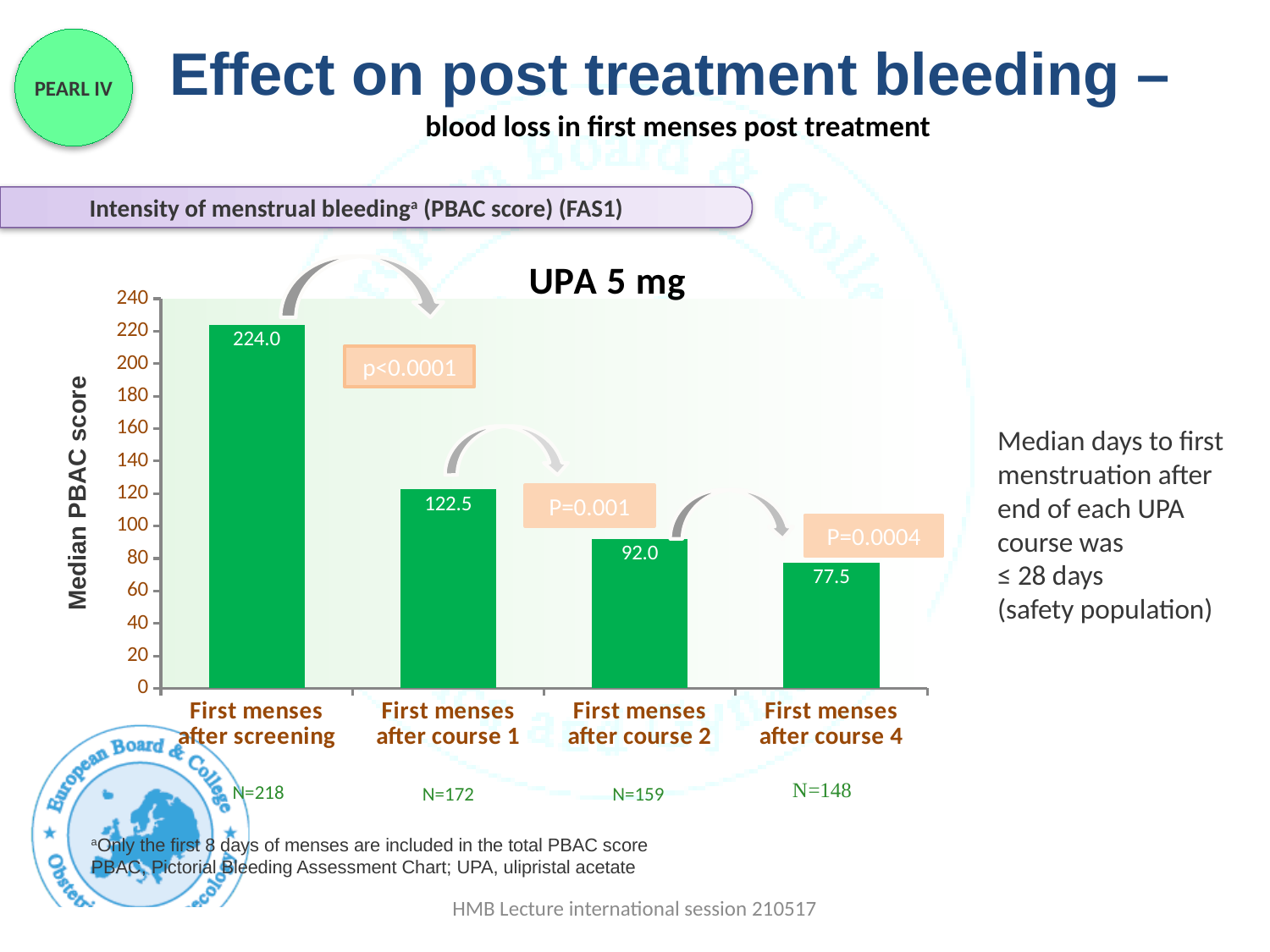
Which category has the highest median PBAC score? First menses after screening What is the median PBAC score for first menses after course 4? 77.5 What is the median PBAC score for first menses after screening? 224.0 Which is larger, the median PBAC score after course 1 or after course 2? After course 1 What is the median PBAC score for first menses after course 1? 122.5 Which category has the lowest median PBAC score? First menses after course 4 What is the difference in median PBAC score between first menses after course 2 and first menses after course 4? 14.5 Do the median PBAC scores rise or fall from left to right across the chart? Fall What is the difference in median PBAC score between first menses after screening and first menses after course 1? 101.5 What is the median PBAC score for first menses after course 2? 92.0 How many categories are shown on the x axis of the chart? 4 What kind of chart is shown on the slide? Bar chart